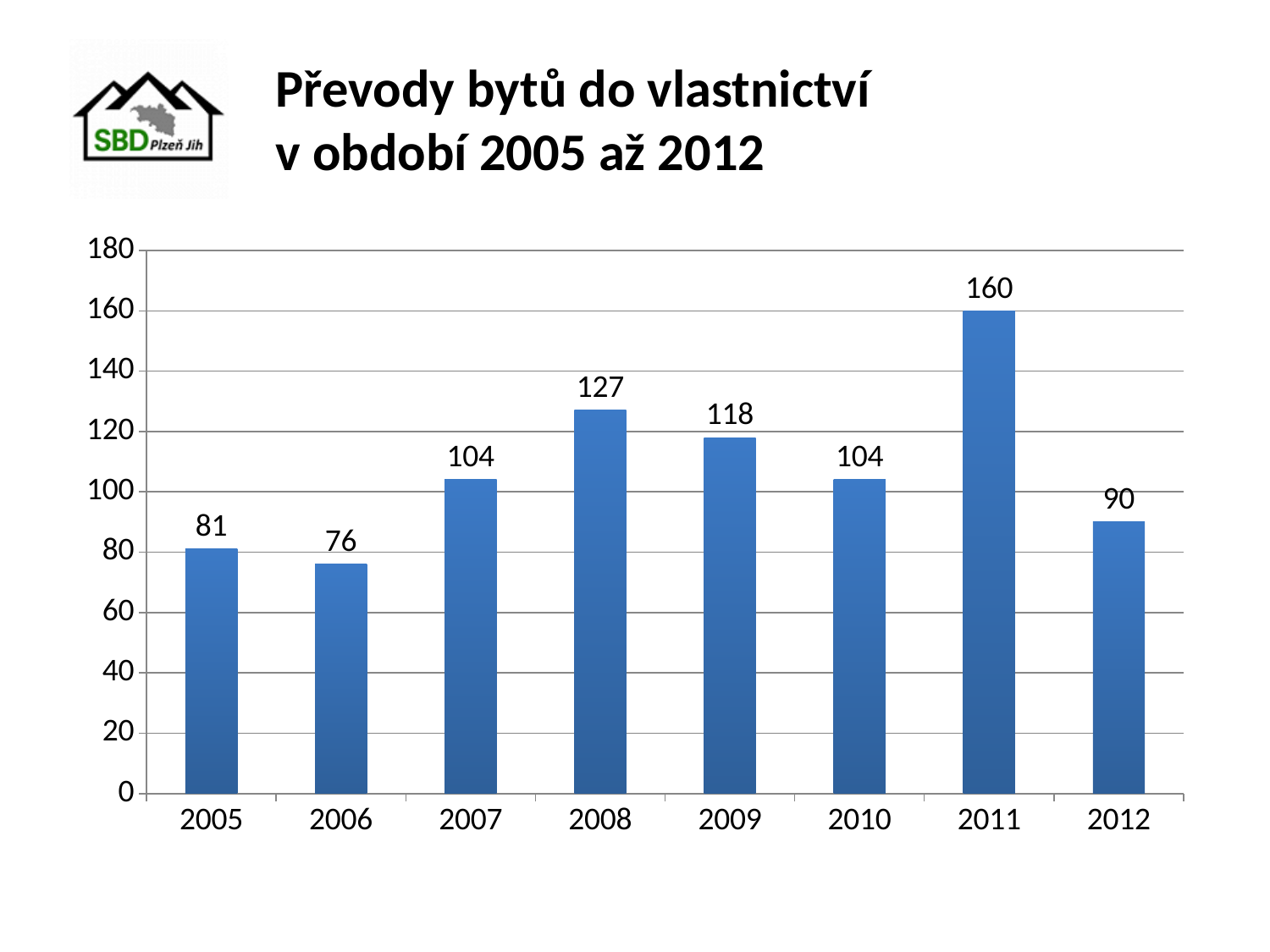
Which year has the highest value? 2011 Which is larger, the value for 2005 or the value for 2012? 2012 What is the value for 2008? 127 How many years are shown on the x axis? 8 What is the value for 2006? 76 Is the value for 2009 greater or less than 100? greater Do the values rise or fall from 2005 to 2008? neither; they fall from 2005 to 2006, then rise to 2008 What kind of chart is shown on the slide? bar chart Which year has the lowest value? 2006 What is the value for 2012? 90 What is the difference between the values for 2011 and 2012? 70 What is the difference between the values for 2009 and 2010? 14